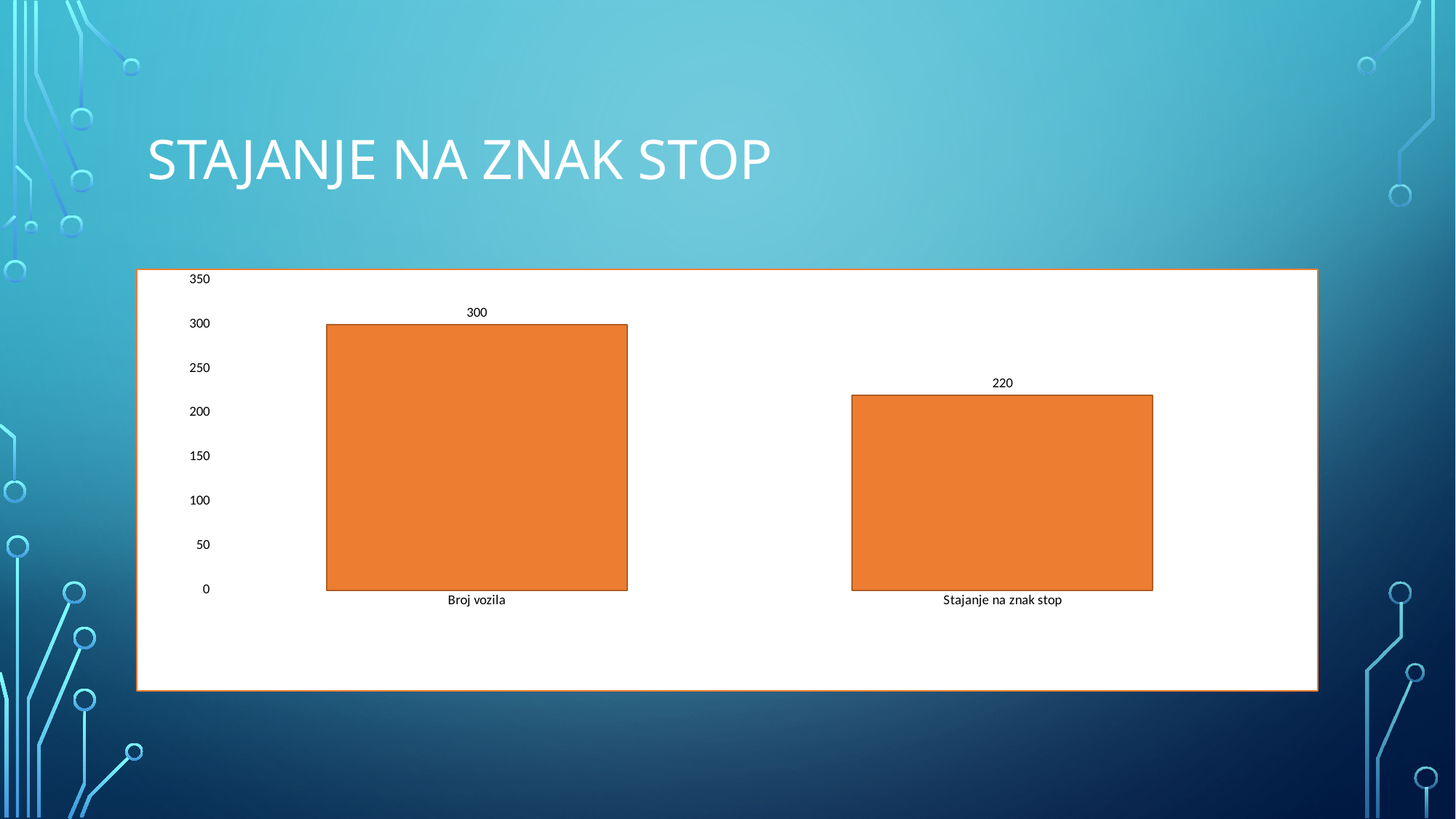
Is the value for Broj vozila greater or less than 250? greater Which category has the lowest value? Stajanje na znak stop What is the value for Broj vozila? 300 What kind of chart is shown on the slide? bar chart What is the value for Stajanje na znak stop? 220 How many categories are shown in the chart? 2 Which is larger, the value for Broj vozila or the value for Stajanje na znak stop? Broj vozila What is the difference between the values for Broj vozila and Stajanje na znak stop? 80 What colour are the bars in the chart? orange Is the value for Stajanje na znak stop greater or less than 250? less Which category has the highest value? Broj vozila What is the title of the slide? STAJANJE NA ZNAK STOP